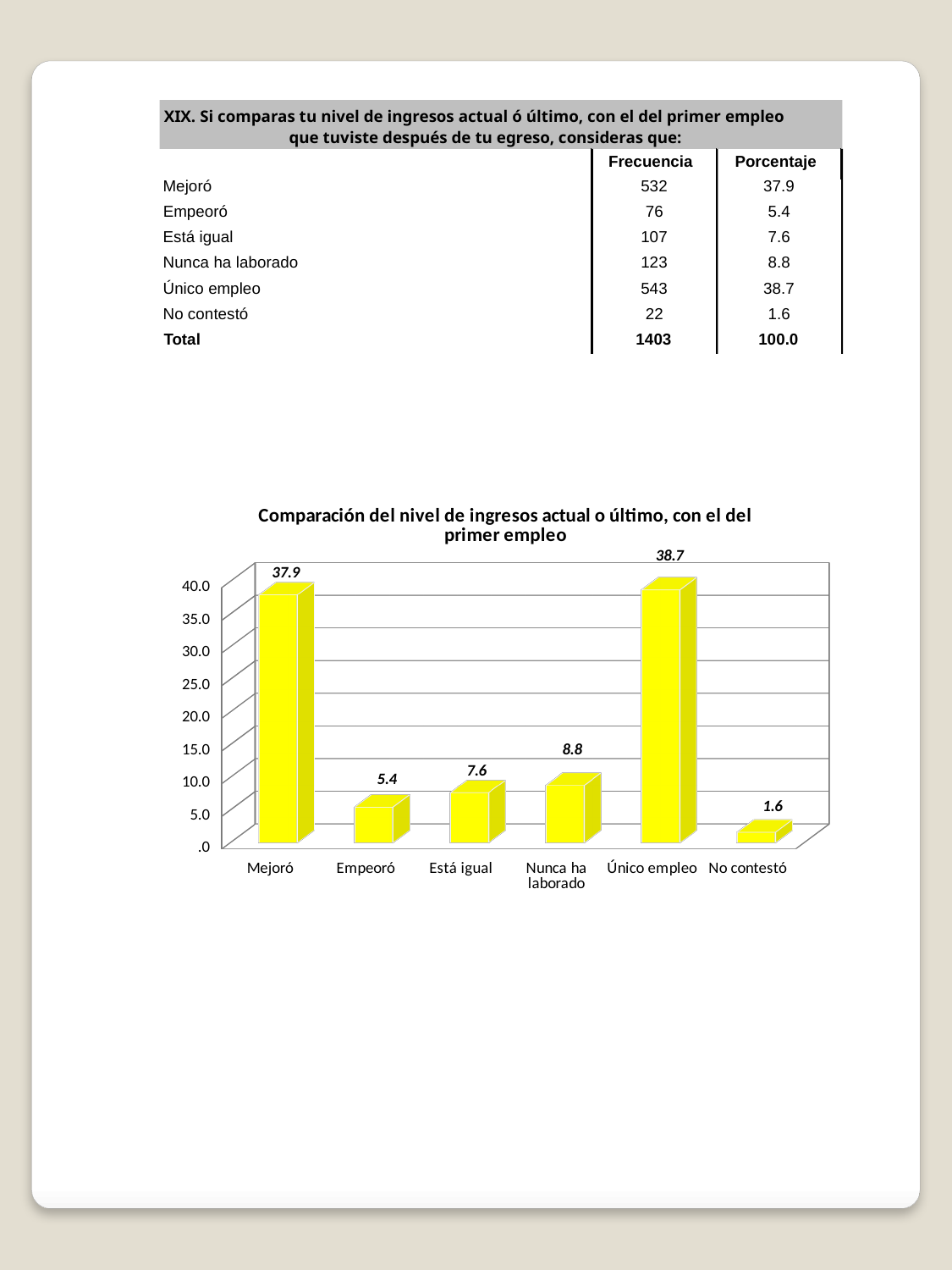
Which category has the lowest value in the chart? No contestó What is the value shown for Nunca ha laborado? 8.8 Which category has the highest value in the chart? Único empleo What kind of chart is shown on the slide? Bar chart How many categories are shown on the x axis of the chart? 6 What is the difference between the values for Único empleo and Mejoró? 0.8 What is the difference between the values for Nunca ha laborado and Empeoró? 3.4 Which is larger, the value for Está igual or the value for Empeoró? Está igual What is the value shown for Mejoró? 37.9 What is the value shown for No contestó? 1.6 What is the value shown for Único empleo? 38.7 What is the title of the chart? Comparación del nivel de ingresos actual o último, con el del primer empleo